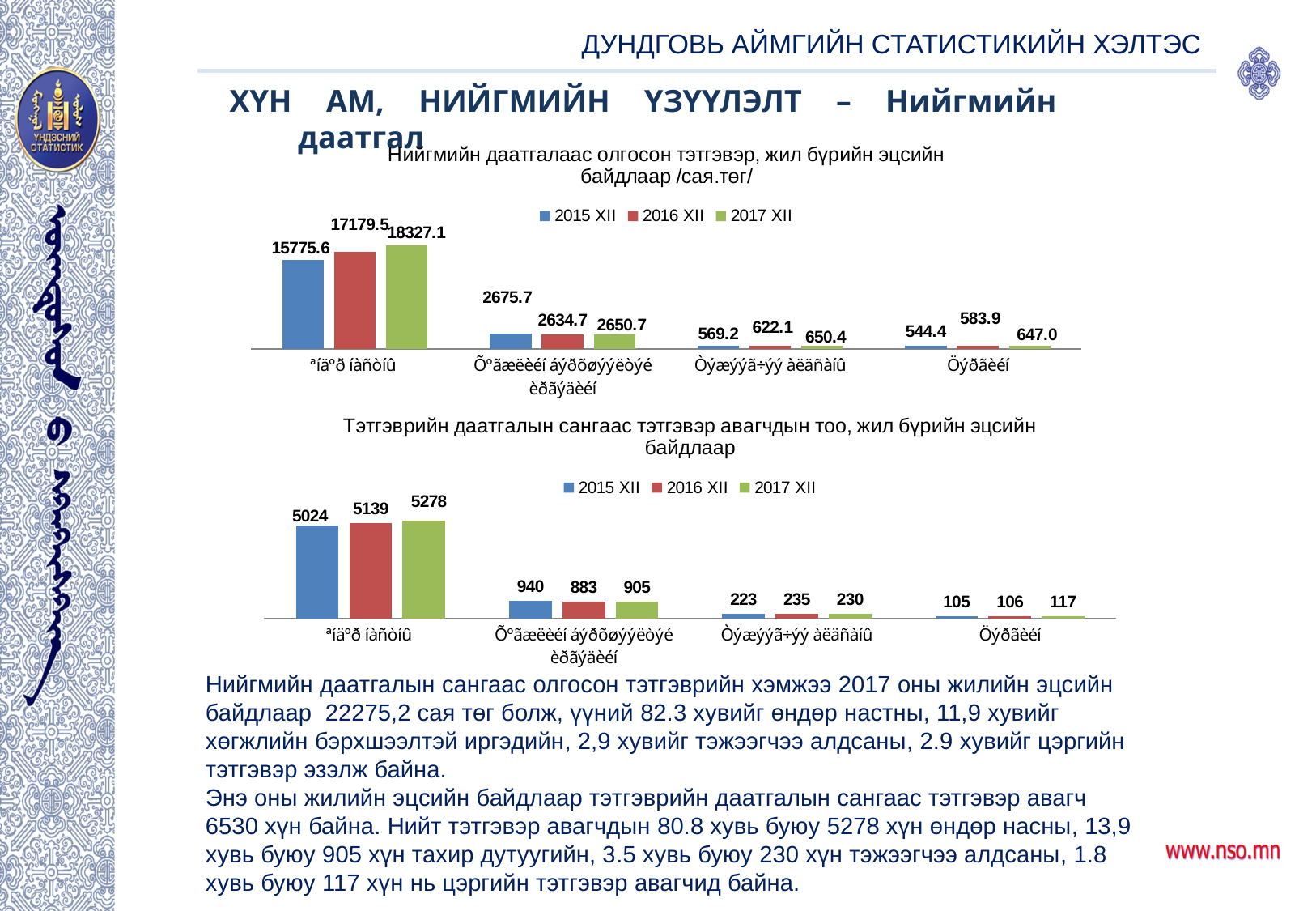
In the top chart, do the values in the leftmost category group rise or fall from 2015 XII to 2017 XII? rise In the bottom chart, what is the difference between the 2017 XII and 2016 XII values in the leftmost category group? 139 In the top chart, what is the difference between the 2017 XII and 2015 XII values in the leftmost category group? 2551.5 In the bottom chart, what is the value of the 2017 XII bar in the leftmost category group? 5278 In the top chart, what is the value of the 2015 XII bar in the leftmost category group? 15775.6 In the bottom chart (Тэтгэврийн даатгалын сангаас тэтгэвэр авагчдын тоо), how many category groups are plotted along the x axis? 4 In the top chart, what is the highest value shown by any bar? 18327.1 In the top chart, what is the lowest value shown by any bar? 544.4 In the bottom chart, what is the lowest value shown by any bar? 105 In the top chart (Нийгмийн даатгалаас олгосон тэтгэвэр), how many series does the legend list? 3 What kind of chart is the top chart on the slide? bar chart In the bottom chart, in the second category group from the left, which is larger: the 2015 XII value or the 2016 XII value? 2015 XII